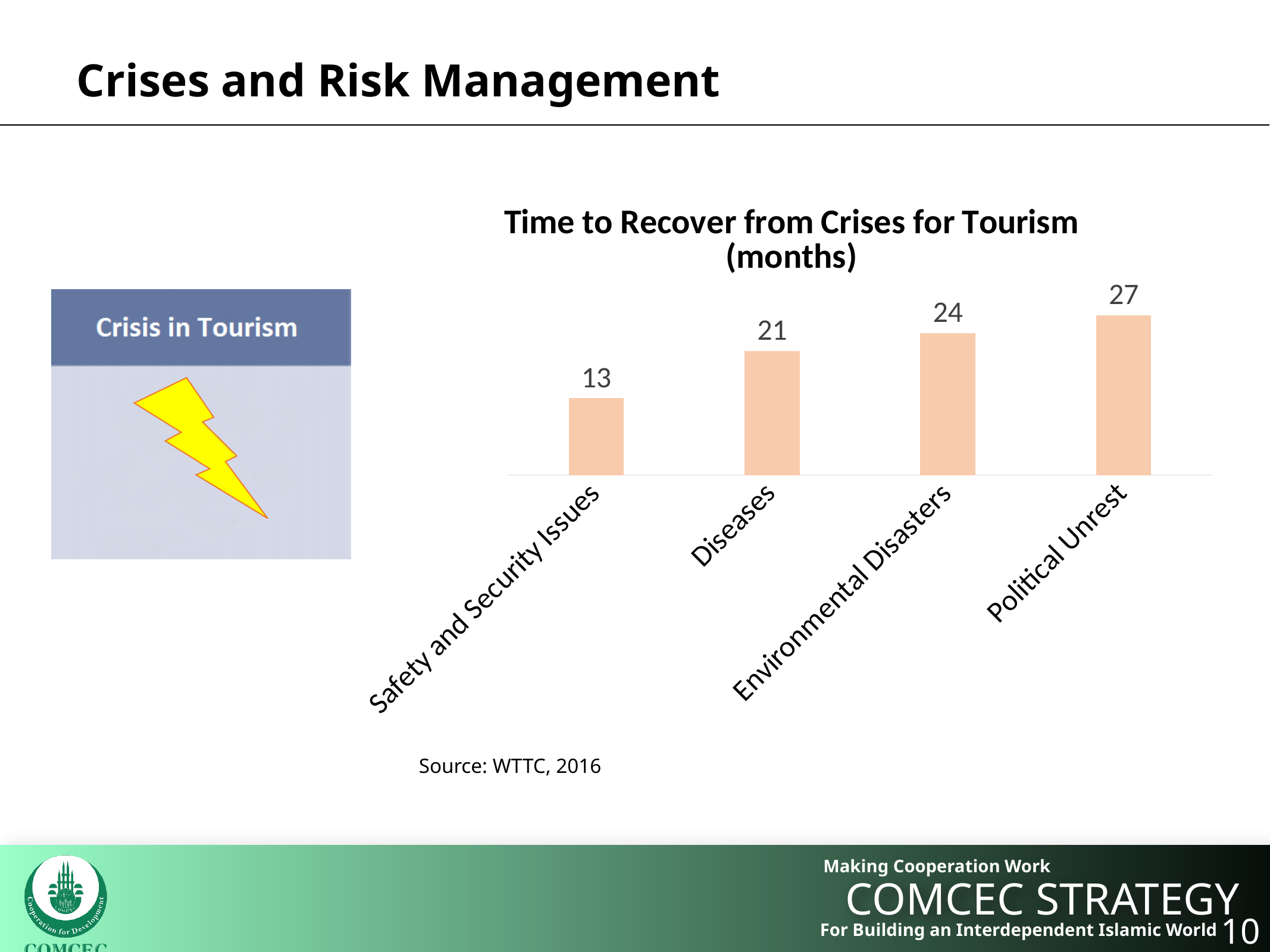
What is the time to recover from Diseases, in months? 21 Do the recovery times rise or fall from left to right across the categories? Rise How many crisis categories are shown in the chart? 4 What is the time to recover from Safety and Security Issues, in months? 13 Which crisis type has the longest recovery time? Political Unrest What type of chart is used to show time to recover from crises? Bar chart How many more months does recovery from Political Unrest take than from Safety and Security Issues? 14 Which crisis type has the shortest recovery time? Safety and Security Issues What is the time to recover from Environmental Disasters, in months? 24 Which takes longer to recover from, Diseases or Environmental Disasters? Environmental Disasters What is the time to recover from Political Unrest, in months? 27 What is the difference in recovery time between Environmental Disasters and Diseases, in months? 3